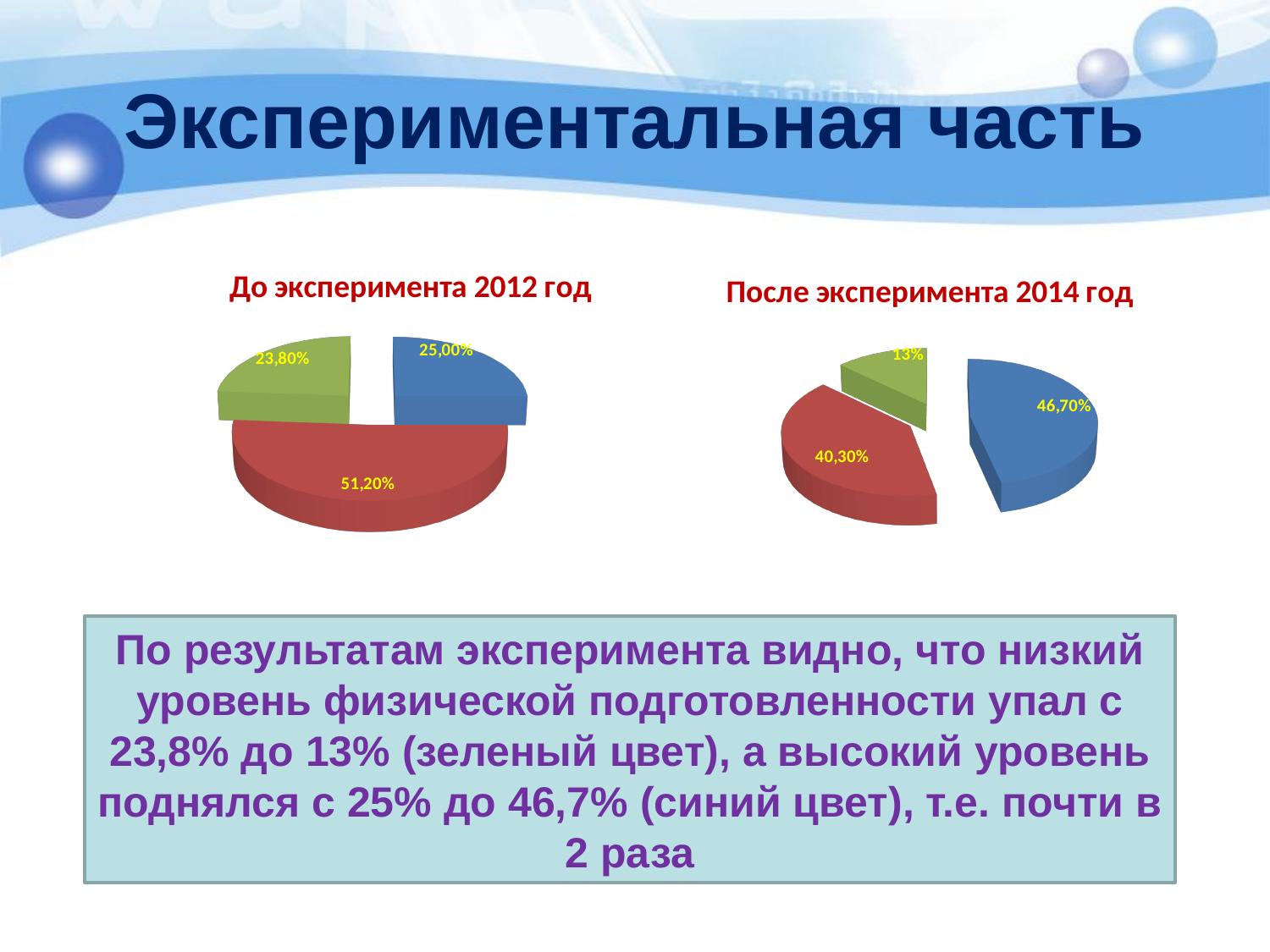
In the chart "После эксперимента 2014 год", what is the difference between the blue slice and the red slice? 6,40% What is the title of the pie chart on the right of the slide? После эксперимента 2014 год In the chart "До эксперимента 2012 год", what value is shown for the green slice? 23,80% How many slices does the chart "После эксперимента 2014 год" have? 3 In the chart "До эксперимента 2012 год", what value is shown for the blue slice? 25,00% In the chart "После эксперимента 2014 год", which colour slice is the largest? blue In the chart "После эксперимента 2014 год", what value is shown for the green slice? 13% In the chart "До эксперимента 2012 год", what value is shown for the red slice? 51,20% In the chart "До эксперимента 2012 год", which is larger, the blue slice or the red slice? red In the chart "До эксперимента 2012 год", which colour slice is the smallest? green What kind of chart is "До эксперимента 2012 год"? pie chart In the chart "После эксперимента 2014 год", what value is shown for the blue slice? 46,70%